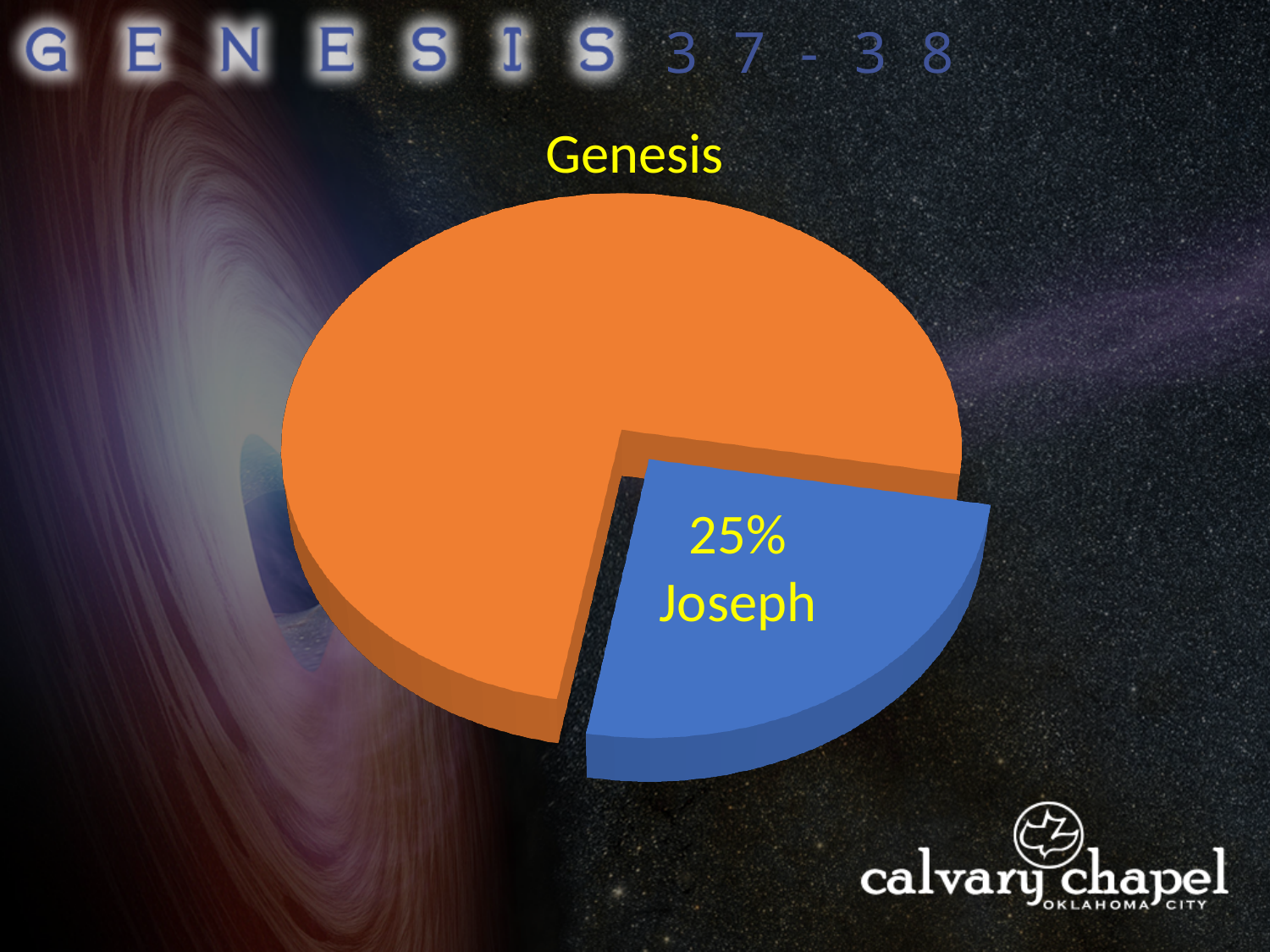
What share of the pie does the Joseph slice represent? 25% What is the title of the chart? Genesis What kind of chart is shown on the slide? pie chart How many slices does the pie chart have? 2 Is the share for Joseph greater or less than 50%? less Which slice is larger, the orange slice or the Joseph slice? the orange slice What is the label on the blue slice of the pie chart? Joseph Which slice of the pie chart is the smallest? Joseph